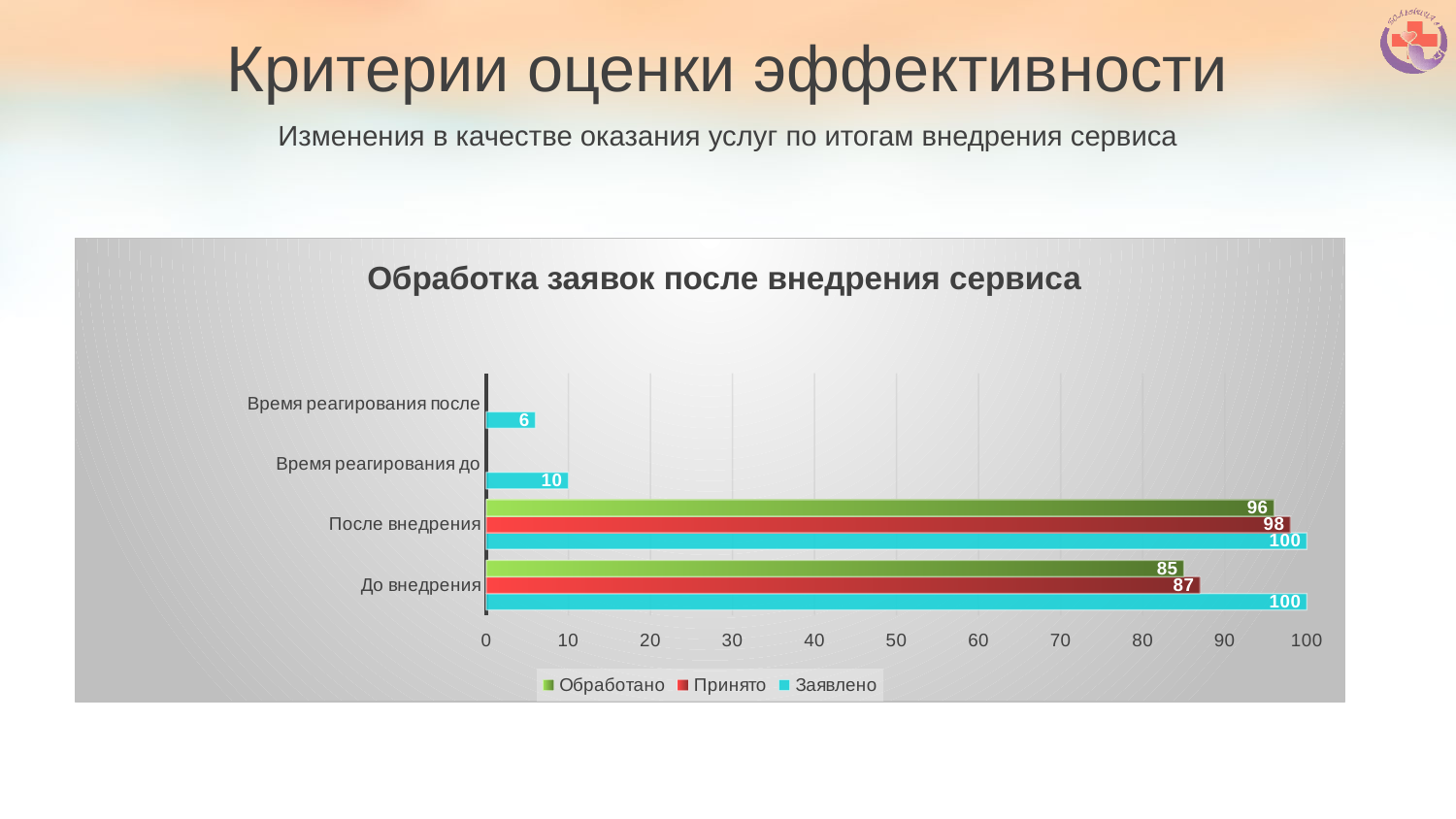
How many categories are shown on the vertical axis? 4 What type of chart is shown? Bar chart What is the value of Принято for После внедрения? 98 What is the value of Заявлено for Время реагирования после? 6 How many series does the legend list? 3 What is the value of Заявлено for Время реагирования до? 10 Which is larger: Обработано for После внедрения or Обработано for До внедрения? После внедрения What is the title of the chart? Обработка заявок после внедрения сервиса Which category has the lowest Заявлено value? Время реагирования после What is the difference between Заявлено and Обработано for До внедрения? 15 What is the value of Обработано for До внедрения? 85 What is the difference between Принято for После внедрения and Принято for До внедрения? 11